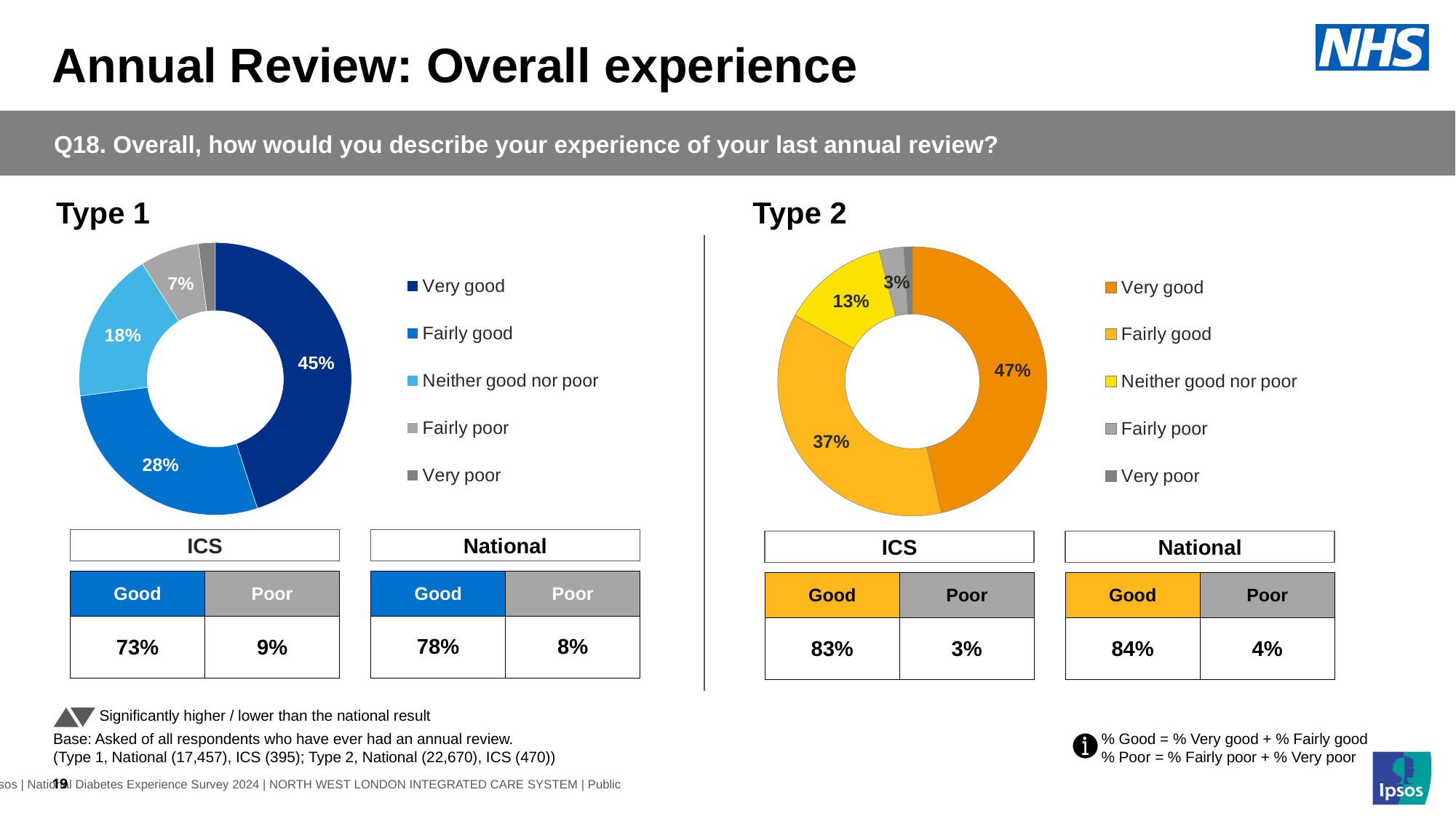
Which is larger: the Neither good nor poor share in the Type 1 chart or in the Type 2 chart? Type 1 What kind of chart is used to show the Type 1 results? Doughnut (pie) chart In the Type 1 chart, what percentage said Neither good nor poor? 18% In the Type 2 chart, what percentage said Fairly poor? 3% In the Type 1 chart, which labelled response category has the smallest share? Fairly poor In the Type 2 chart, what percentage of respondents said their experience was Fairly good? 37% How many response categories does the legend of the Type 2 chart list? 5 In the Type 1 chart, what percentage of respondents said their experience was Very good? 45% In the Type 1 chart, what is the combined share of Very good and Fairly good? 73% In the Type 2 chart, what colour represents Neither good nor poor? Yellow In the Type 2 chart, which response category has the largest share? Very good In the Type 1 chart, what is the difference between the Very good and Fairly good shares? 17 percentage points